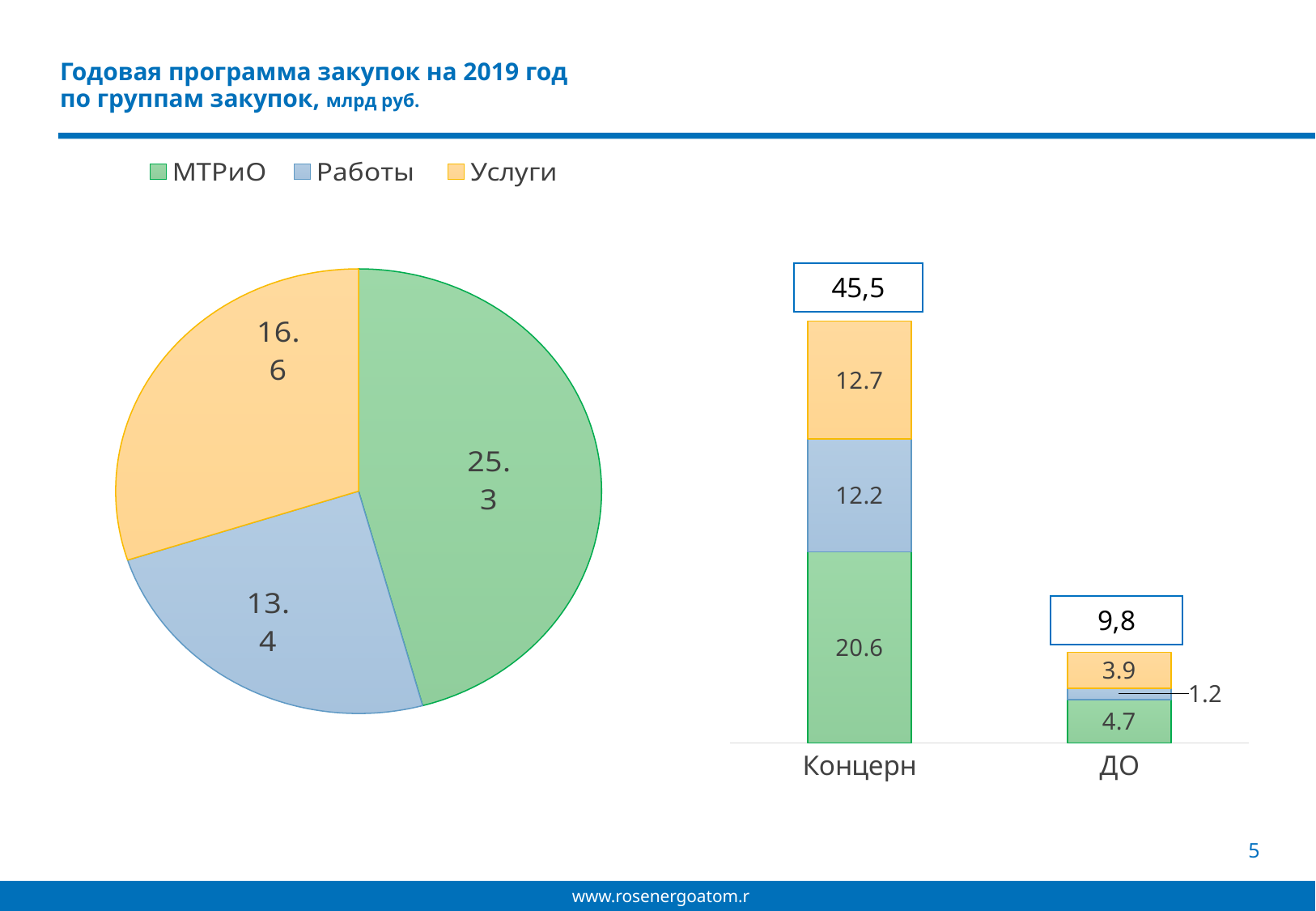
In the pie chart on the left, what is the difference between the МТРиО and Услуги values? 8.7 What kind of chart is shown on the right side of the slide? Stacked bar chart In the stacked bar chart on the right, what is the МТРиО value for Концерн? 20.6 In the stacked bar chart on the right, what is the total shown above the Концерн bar? 45,5 In the stacked bar chart on the right, what is the total shown above the ДО bar? 9,8 In the stacked bar chart on the right, what is the Работы value for ДО? 1.2 In the stacked bar chart on the right, which is larger: the Услуги value for Концерн or the Услуги value for ДО? Концерн How many series does the legend list? 3 In the pie chart on the left, which group has the largest slice? МТРиО In the pie chart on the left, what is the value of the Работы slice? 13.4 In the pie chart on the left, what is the value of the МТРиО slice? 25.3 In the pie chart on the left, which group has the smallest slice? Работы